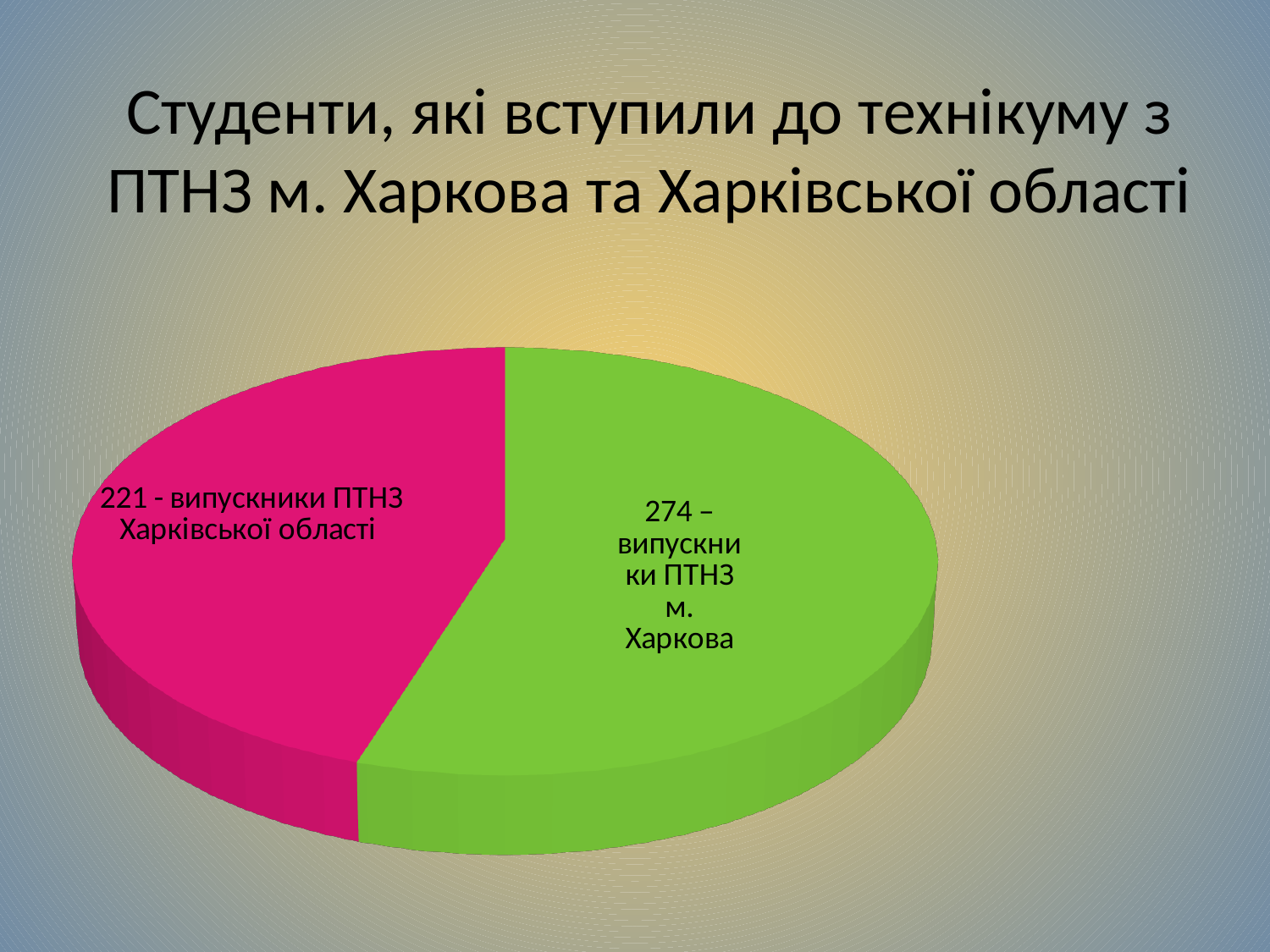
What is the total number of students represented in the pie chart? 495 What is the difference between the number of graduates of ПТНЗ м. Харкова and graduates of ПТНЗ Харківської області? 53 How many slices does the pie chart have? 2 What is the title of the slide containing the pie chart? Студенти, які вступили до технікуму з ПТНЗ м. Харкова та Харківської області How many students are graduates of ПТНЗ м. Харкова according to the pie chart? 274 Which group is larger in the pie chart: випускники ПТНЗ м. Харкова or випускники ПТНЗ Харківської області? випускники ПТНЗ м. Харкова What colour is the slice for випускники ПТНЗ Харківської області? magenta (pink) Which slice of the pie chart is the largest? 274 – випускники ПТНЗ м. Харкова How many students are graduates of ПТНЗ Харківської області according to the pie chart? 221 Which slice of the pie chart is the smallest? 221 - випускники ПТНЗ Харківської області What type of chart is shown on the slide? pie chart